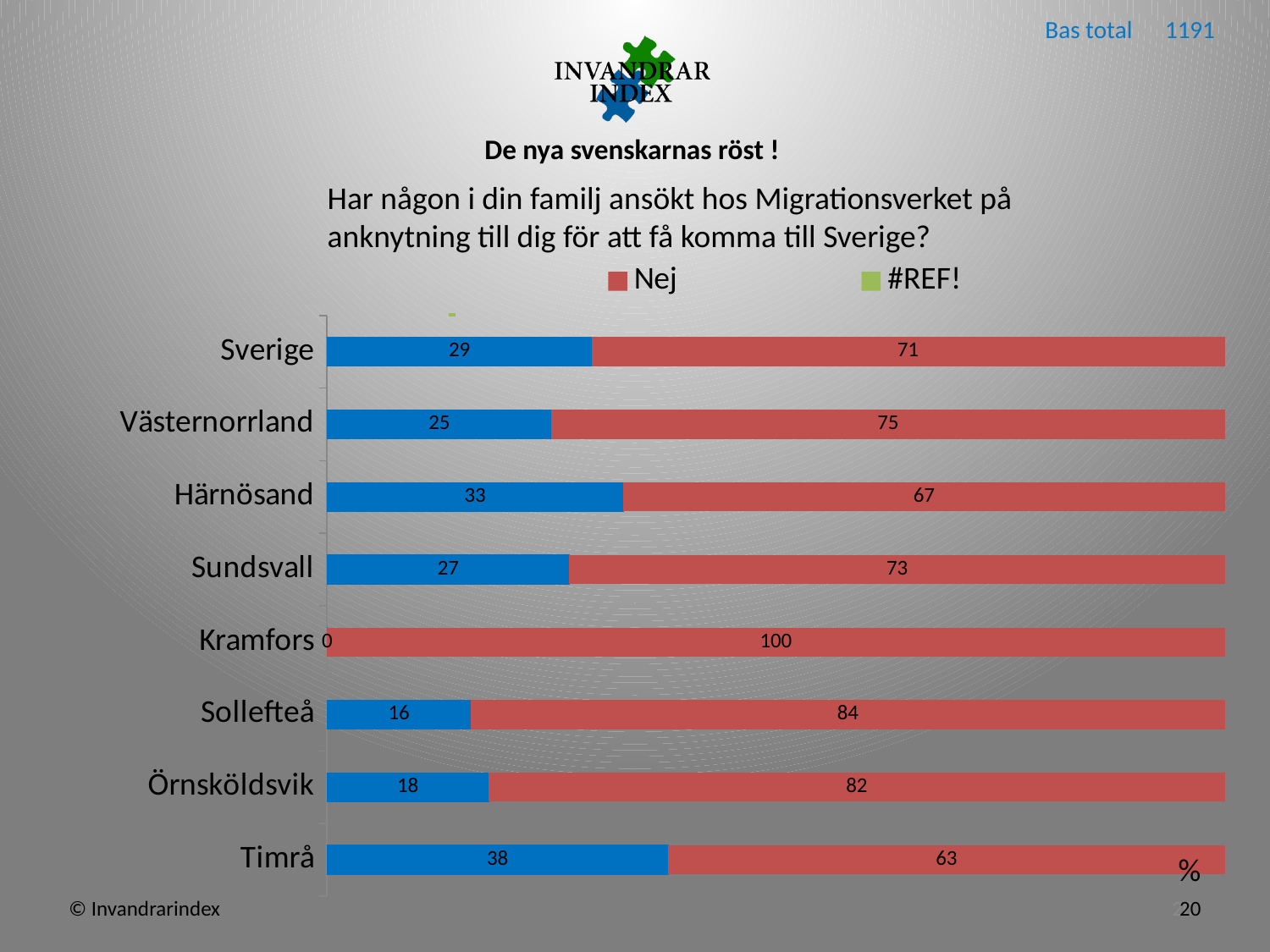
How many categories are shown on the chart? 8 What value is printed on the blue segment for Timrå? 38 Which has the larger Nej value, Sverige or Västernorrland? Västernorrland What is the total of the two labelled segments in the Sverige bar? 100 How many series does the legend list? 2 What is the Nej value for Härnösand? 67 What kind of chart is shown on the slide? Stacked bar chart What value is printed on the blue segment for Kramfors? 0 What is the difference between the Nej values for Sollefteå and Örnsköldsvik? 2 Which category has the highest Nej value? Kramfors Which category has the lowest Nej value? Timrå What are the two entries listed in the chart legend? Nej and #REF!